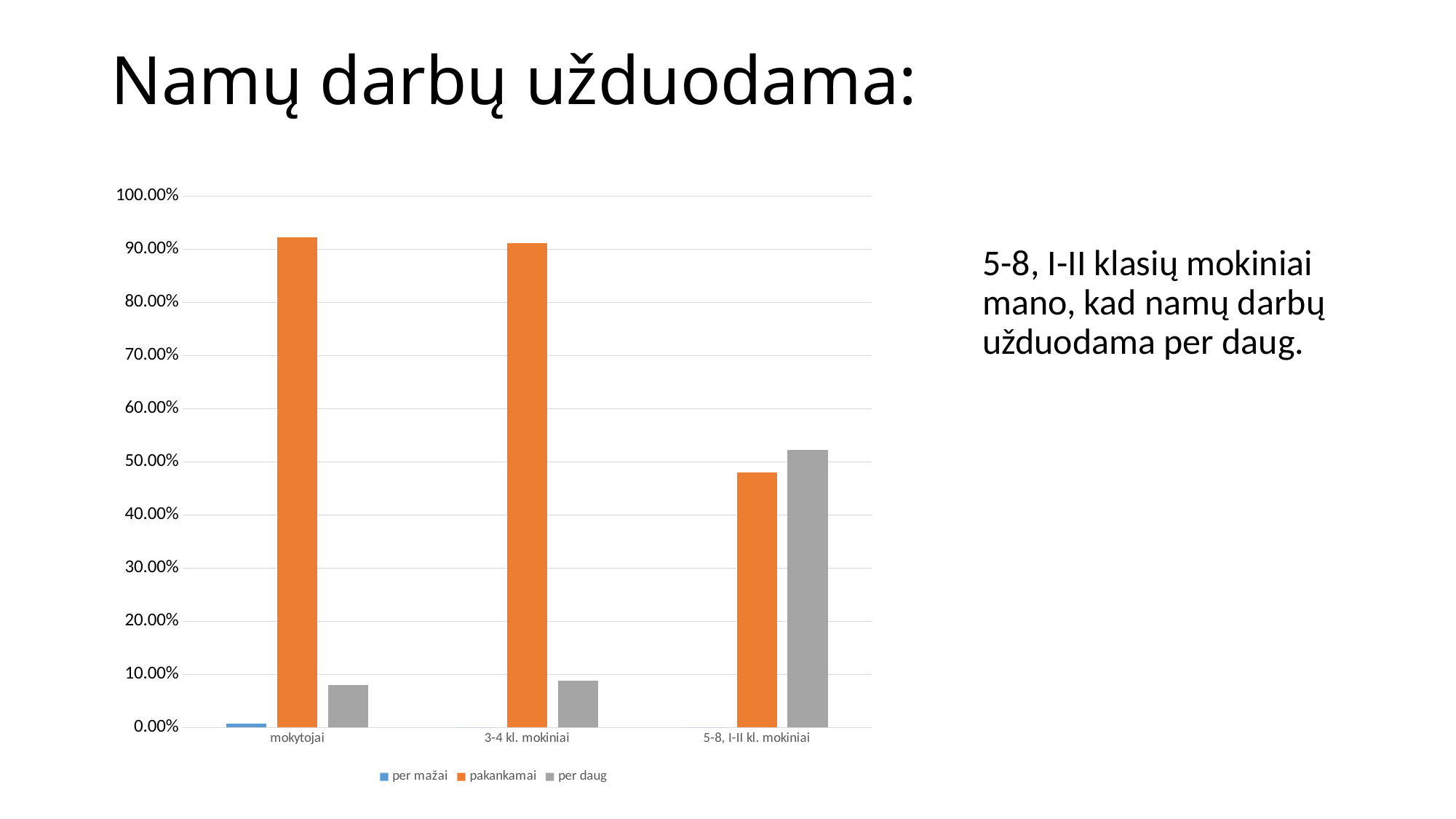
How many series does the legend list? 3 Which colour represents the 'per daug' series? grey Which category has the lowest 'pakankamai' value? 5-8, I-II kl. mokiniai Which series does the legend list first? per mažai For mokytojai, which is larger: the 'pakankamai' value or the 'per daug' value? pakankamai What kind of chart is shown on the slide? bar chart Is the 'per daug' value for 5-8, I-II kl. mokiniai greater or less than 50.00%? greater Which category has the highest 'per daug' value? 5-8, I-II kl. mokiniai Is the 'pakankamai' value for mokytojai greater or less than 90.00%? greater Is the 'pakankamai' value for 5-8, I-II kl. mokiniai greater or less than 50.00%? less How many categories are shown on the x axis? 3